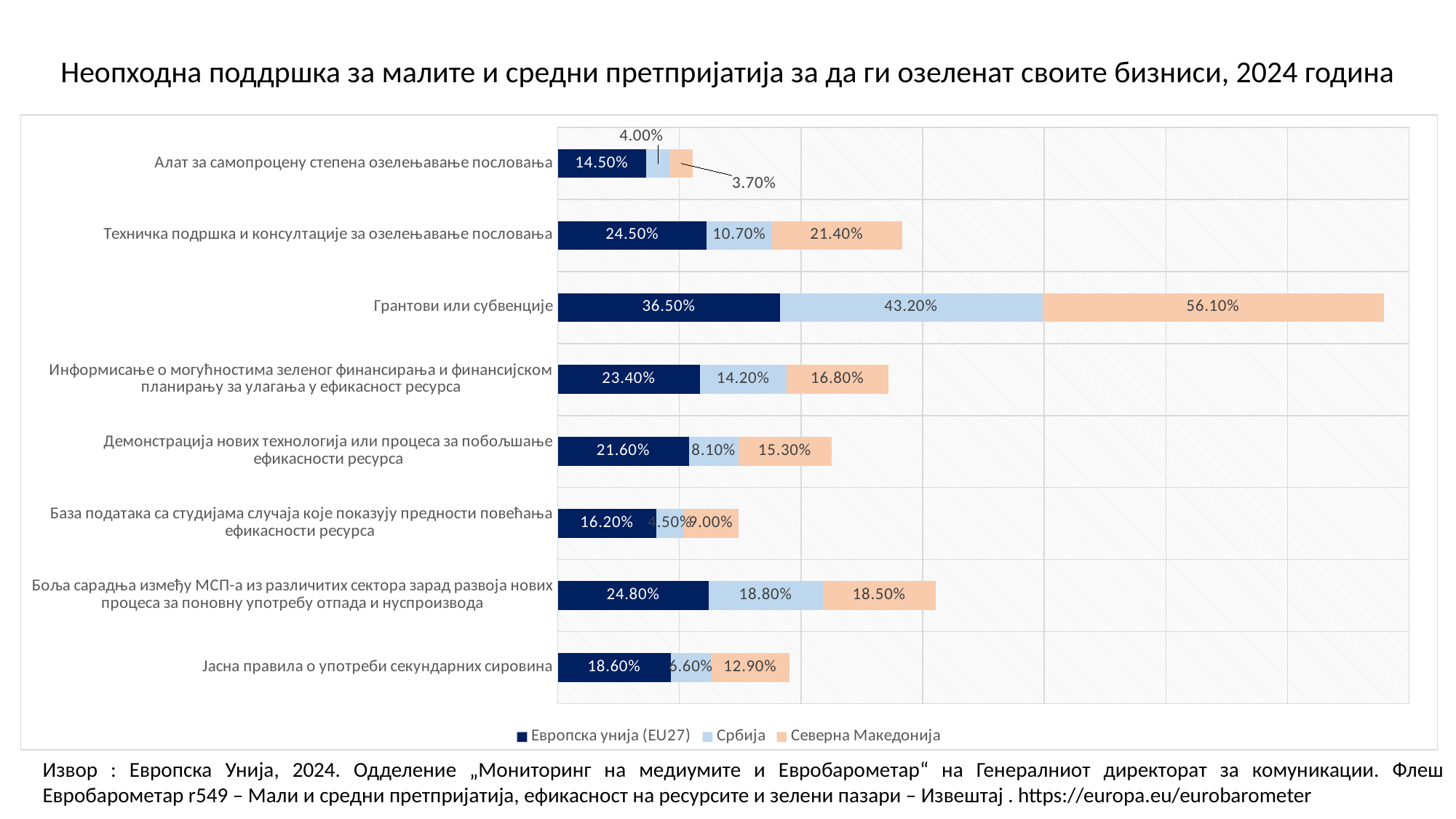
How many series does the legend list? 3 What is the difference between the Северна Македонија value and the Европска унија (EU27) value for Грантови или субвенције? 19.60 percentage points What type of chart is shown on the slide? Stacked bar chart What is the value for Северна Македонија in the category Јасна правила о употреби секундарних сировина? 12.90% Which series is shown in the darkest blue colour in the legend? Европска унија (EU27) How many categories are plotted on the chart? 8 What is the total of the stacked bar for Техничка подршка и консултације за озелењавање пословања? 56.60% What is the value for Србија in the category Техничка подршка и консултације за озелењавање пословања? 10.70% Which category has the lowest value for Србија? Алат за самопроцену степена озелењавање пословања What is the value for Европска унија (EU27) in the category Грантови или субвенције? 36.50% Which is larger for Демонстрација нових технологија или процеса за побољшање ефикасности ресурса: the value for Србија or the value for Северна Македонија? Северна Македонија Which category has the highest value for Северна Македонија? Грантови или субвенције